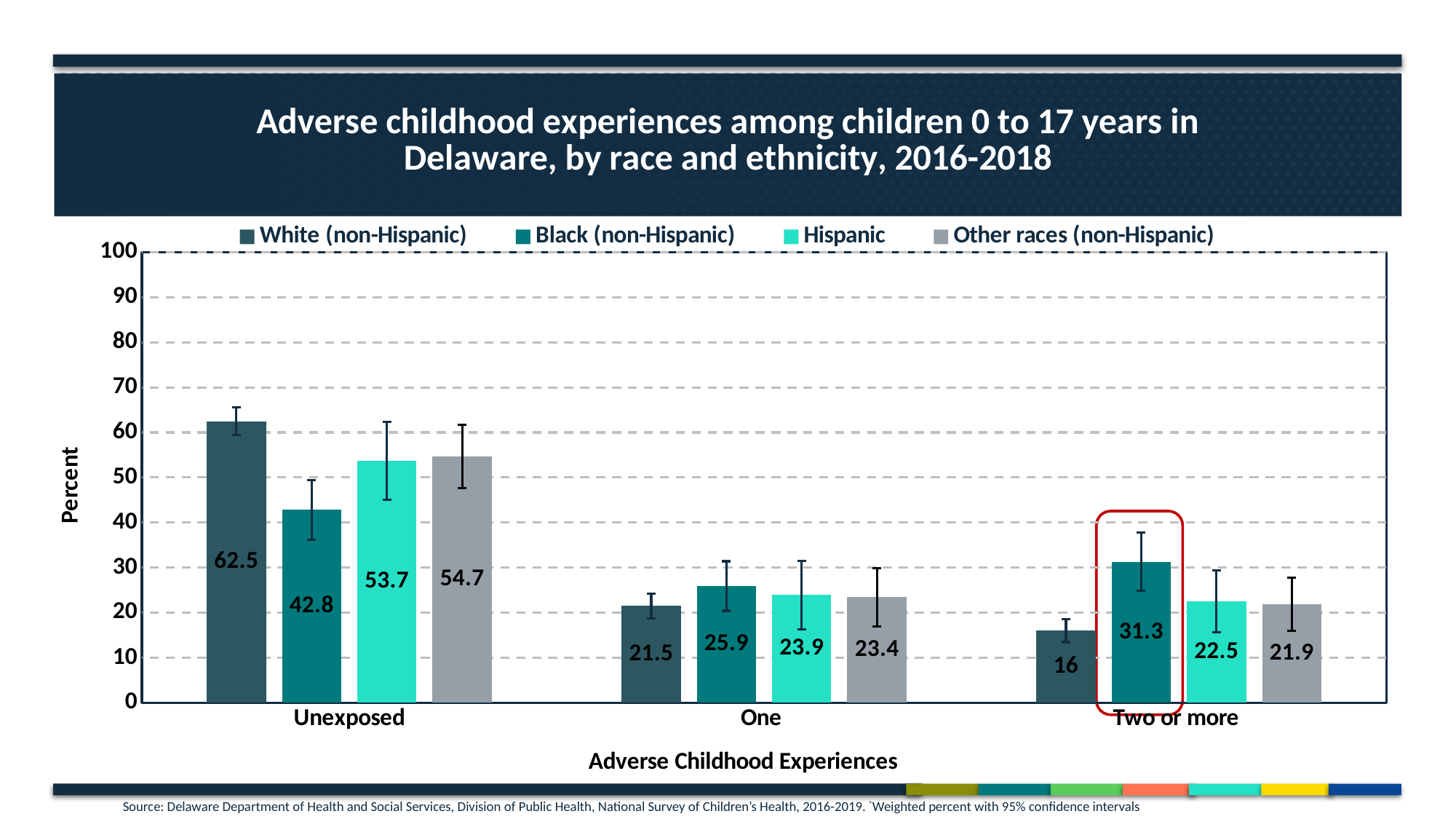
What is the label of the y axis? Percent What kind of chart is shown on the slide? Bar chart Is the value for Other races (non-Hispanic) in the Unexposed category greater or less than 50? greater What is the value for White (non-Hispanic) children in the Unexposed category? 62.5 Which race/ethnicity group has the highest value in the Unexposed category? White (non-Hispanic) Which race/ethnicity group has the lowest value in the Two or more category? White (non-Hispanic) What is the difference between the White (non-Hispanic) and Black (non-Hispanic) values in the Unexposed category? 19.7 How many categories are shown on the x axis? 3 What is the value for Black (non-Hispanic) children in the Two or more category? 31.3 In the One category, which is larger: the value for Black (non-Hispanic) or the value for White (non-Hispanic)? Black (non-Hispanic) What is the value for Hispanic children in the One category? 23.9 How many series does the legend list? 4